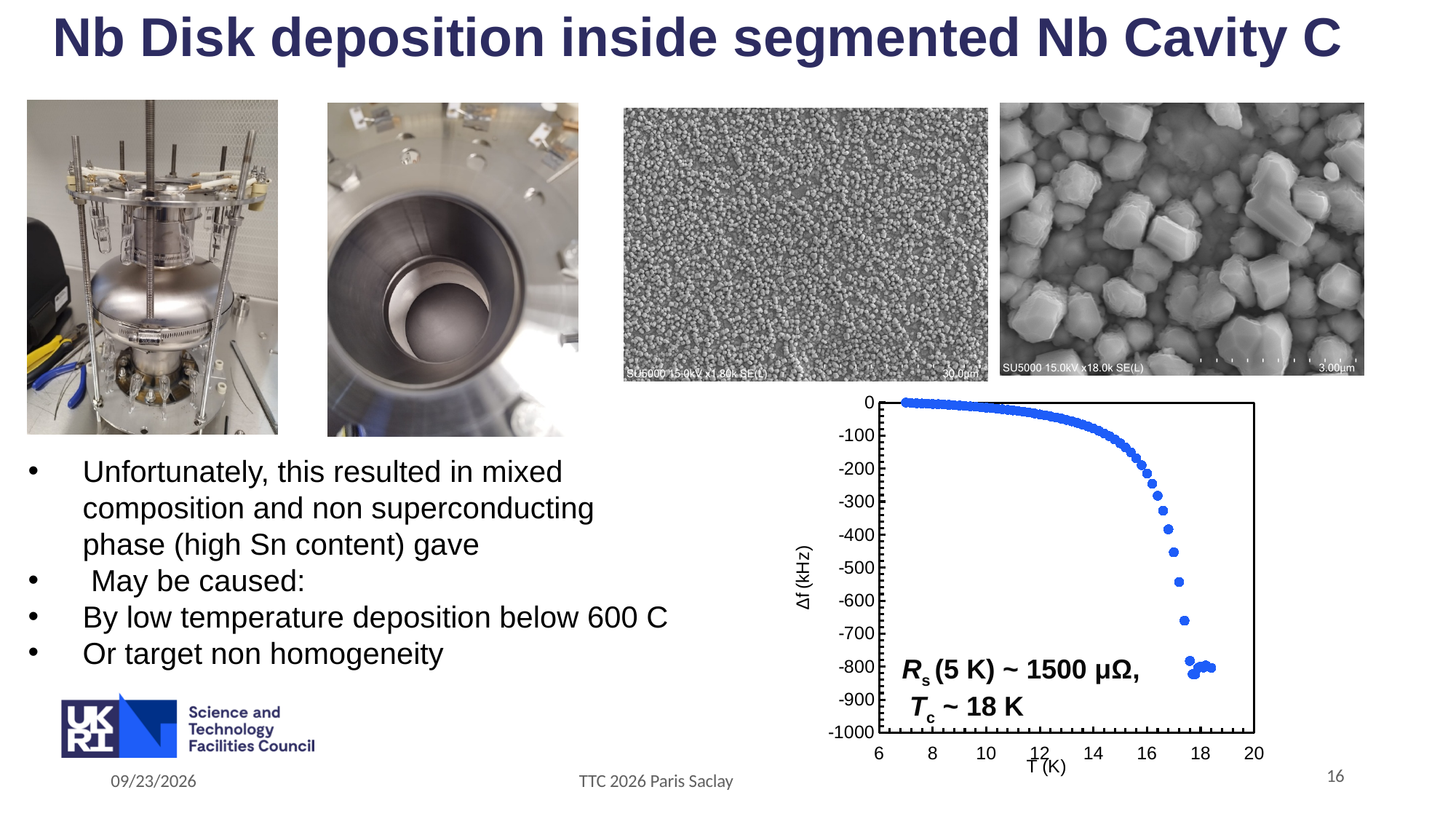
Is the Δf value at T = 14 K greater or less than -200 kHz? greater What kind of chart is shown at the bottom right of the slide? scatter plot Do the plotted Δf values rise or fall as T increases along the x axis? fall What is the highest value shown on the x axis of the chart? 20 Is the Δf value at T = 10 K greater or less than -100 kHz? greater What is the label of the x axis of the chart? T (K) What is the lowest value shown on the y axis of the chart? -1000 What value of Tc is stated in the annotation on the chart? ~ 18 K Which is larger, the Δf value at T = 8 K or the Δf value at T = 18 K? T = 8 K Is the Δf value at T = 17 K greater or less than -100 kHz? less